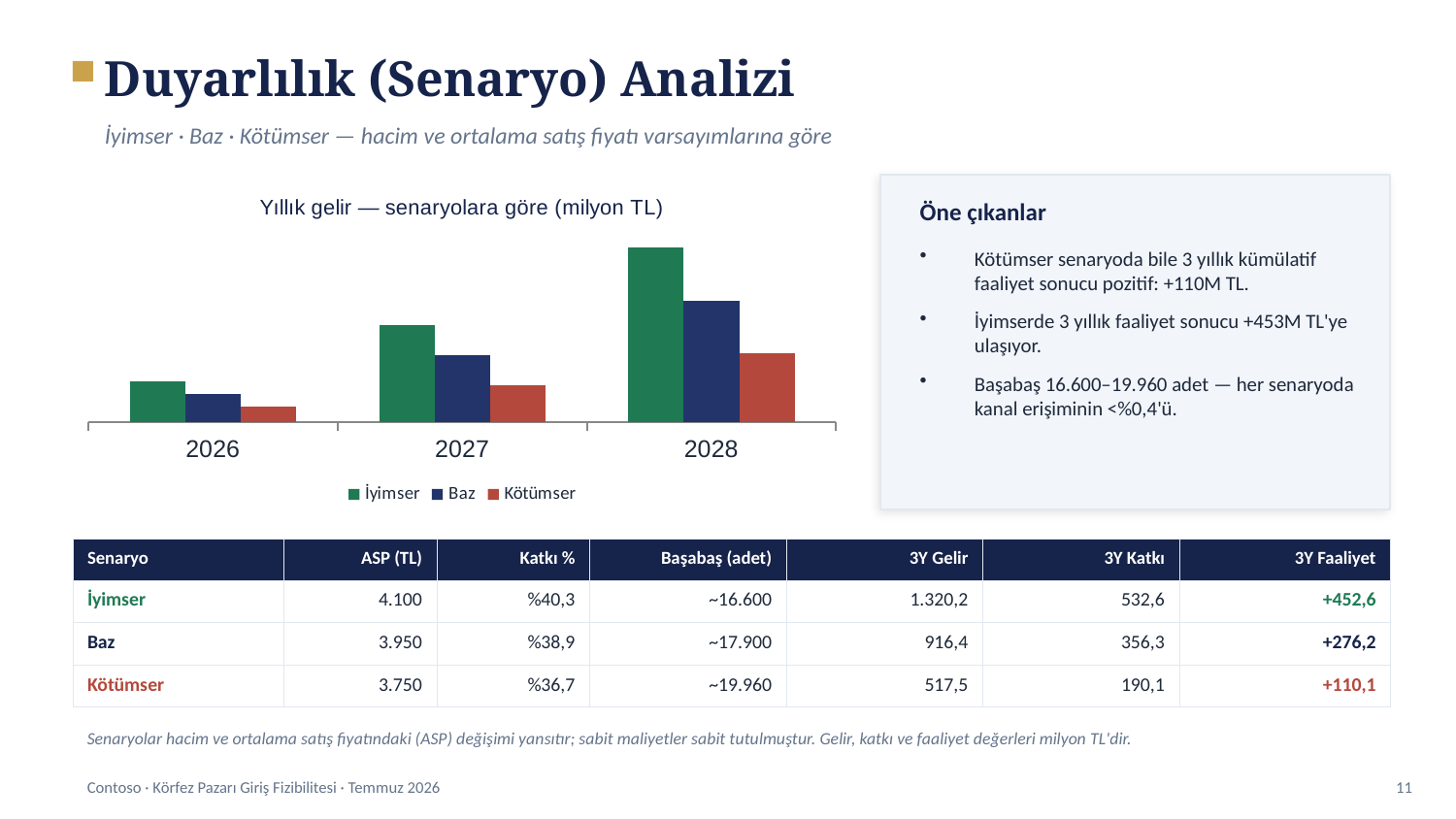
Do the İyimser bars rise or fall from 2026 to 2028? rise What kind of chart is shown on the slide? bar chart Which scenario has the highest bar in 2028? İyimser Which scenario has the lowest bar in 2026? Kötümser What is the title of the chart? Yıllık gelir — senaryolara göre (milyon TL) Which is larger: the İyimser bar for 2027 or the Baz bar for 2028? Baz bar for 2028 What are the three entries in the chart legend? İyimser, Baz, Kötümser Do the Kötümser bars rise or fall from 2026 to 2028? rise In which year is the Baz bar the tallest? 2028 How many years are shown on the x axis of the chart? 3 How many series does the chart legend list? 3 In 2027, which is larger: the İyimser bar or the Baz bar? İyimser